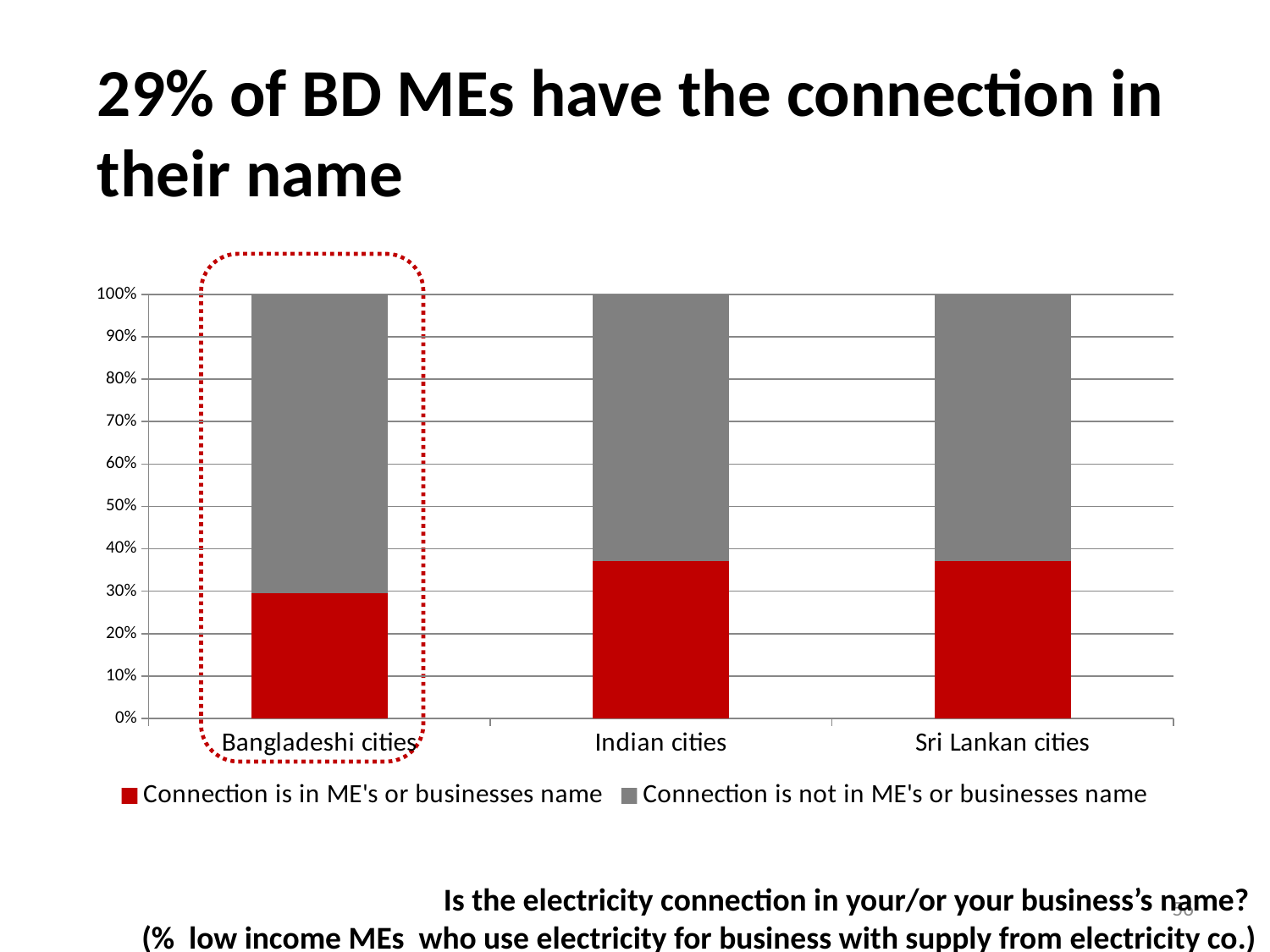
Which colour represents 'Connection is not in ME's or businesses name' in the chart? grey Is the value for 'Connection is in ME's or businesses name' in Indian cities greater or less than 30%? greater What kind of chart is shown on the slide? stacked bar chart Is the value for 'Connection is not in ME's or businesses name' in Bangladeshi cities greater or less than 60%? greater Is the value for 'Connection is in ME's or businesses name' in Sri Lankan cities greater or less than 40%? less Which category has the lowest value for 'Connection is in ME's or businesses name'? Bangladeshi cities How many categories (city groups) are shown on the x axis of the chart? 3 Which is larger: the 'Connection is in ME's or businesses name' value for Bangladeshi cities or for Indian cities? Indian cities According to the slide title, what percentage of BD MEs have the connection in their name? 29% How many series does the chart's legend list? 2 Which category has the highest value for 'Connection is not in ME's or businesses name'? Bangladeshi cities